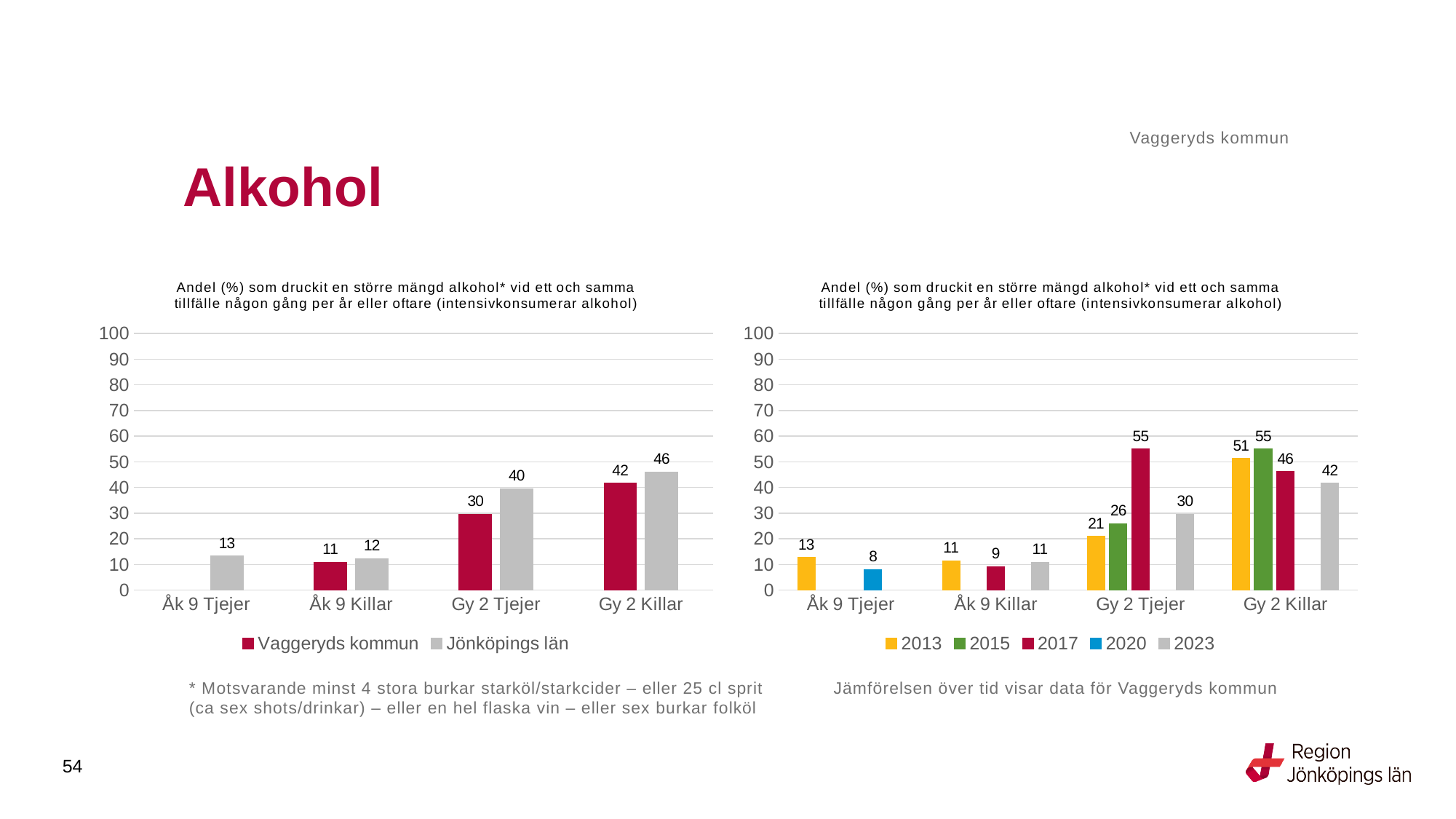
On the left chart, what is the value for Jönköpings län for Gy 2 Tjejer? 40 On the right chart, what is the value for 2020 for Åk 9 Tjejer? 8 On the left chart, which category has the highest value for Jönköpings län? Gy 2 Killar On the right chart, how many categories are shown on the x axis? 4 On the right chart, what is the difference between 2015 and 2023 for Gy 2 Killar? 13 On the left chart, what is the difference between Jönköpings län and Vaggeryds kommun for Gy 2 Tjejer? 10 On the right chart, what is the value for 2017 for Gy 2 Tjejer? 55 On the left chart, how many series does the legend list? 2 On the right chart, how many series does the legend list? 5 On the left chart, what is the value for Vaggeryds kommun for Gy 2 Killar? 42 What kind of chart is the left chart? Bar chart On the right chart, which is larger for Gy 2 Killar: 2013 or 2023? 2013